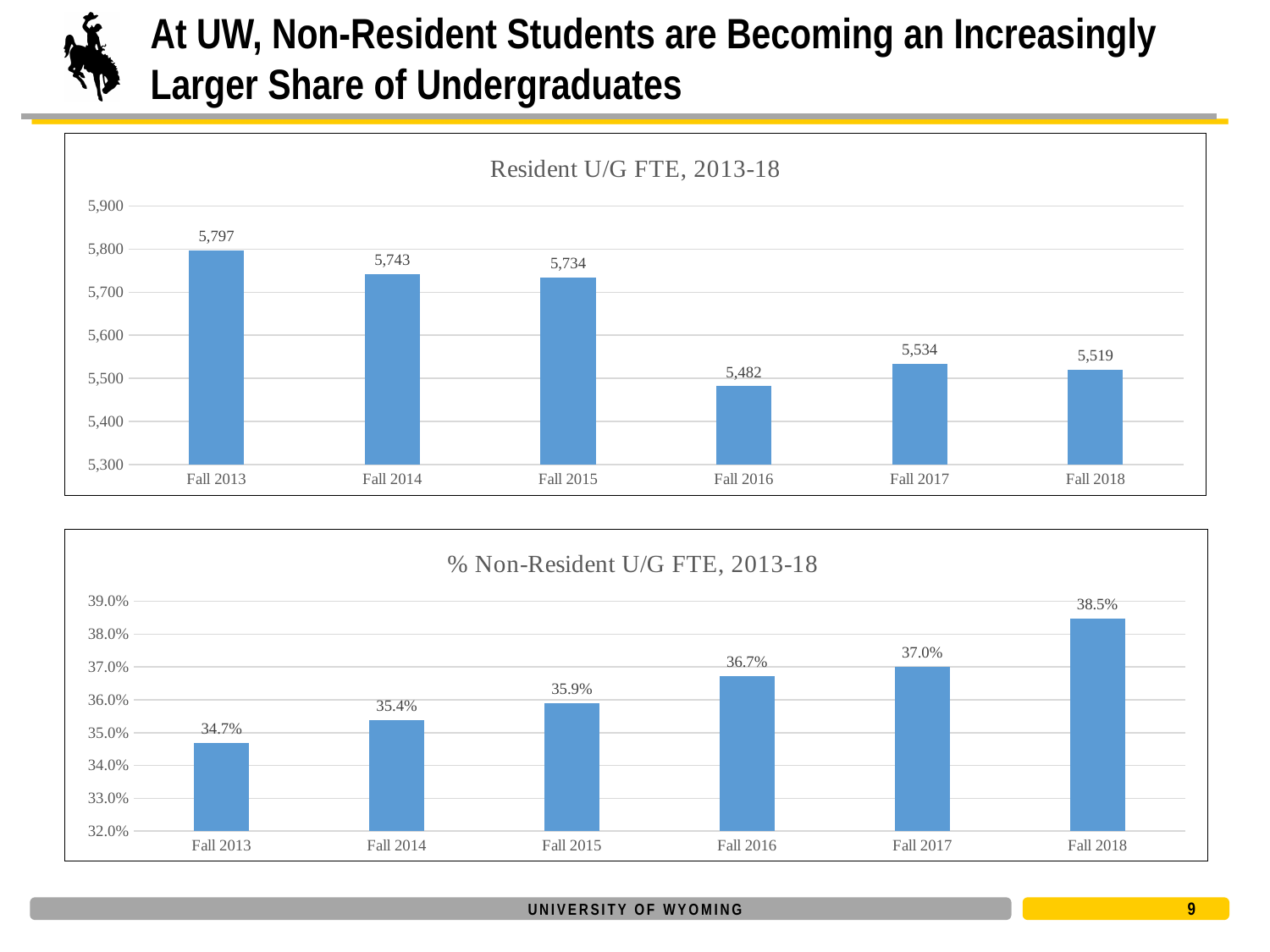
In the '% Non-Resident U/G FTE, 2013-18' chart, which is larger, the value for Fall 2014 or the value for Fall 2017? Fall 2017 In the '% Non-Resident U/G FTE, 2013-18' chart, do the values rise or fall from Fall 2013 to Fall 2018? rise In the 'Resident U/G FTE, 2013-18' chart, what is the difference between the Fall 2013 and Fall 2018 values? 278 In the 'Resident U/G FTE, 2013-18' chart, how many years are shown on the x axis? 6 In the '% Non-Resident U/G FTE, 2013-18' chart, which year has the highest value? Fall 2018 In the 'Resident U/G FTE, 2013-18' chart, is the value for Fall 2017 greater or less than 5,600? less In the 'Resident U/G FTE, 2013-18' chart, which year has the highest value? Fall 2013 In the '% Non-Resident U/G FTE, 2013-18' chart, what is the difference between the Fall 2018 and Fall 2013 values? 3.8% In the 'Resident U/G FTE, 2013-18' chart, what is the value for Fall 2016? 5,482 In the 'Resident U/G FTE, 2013-18' chart, which year has the lowest value? Fall 2016 In the '% Non-Resident U/G FTE, 2013-18' chart, what is the value for Fall 2015? 35.9% What kind of chart is the 'Resident U/G FTE, 2013-18' chart? bar chart